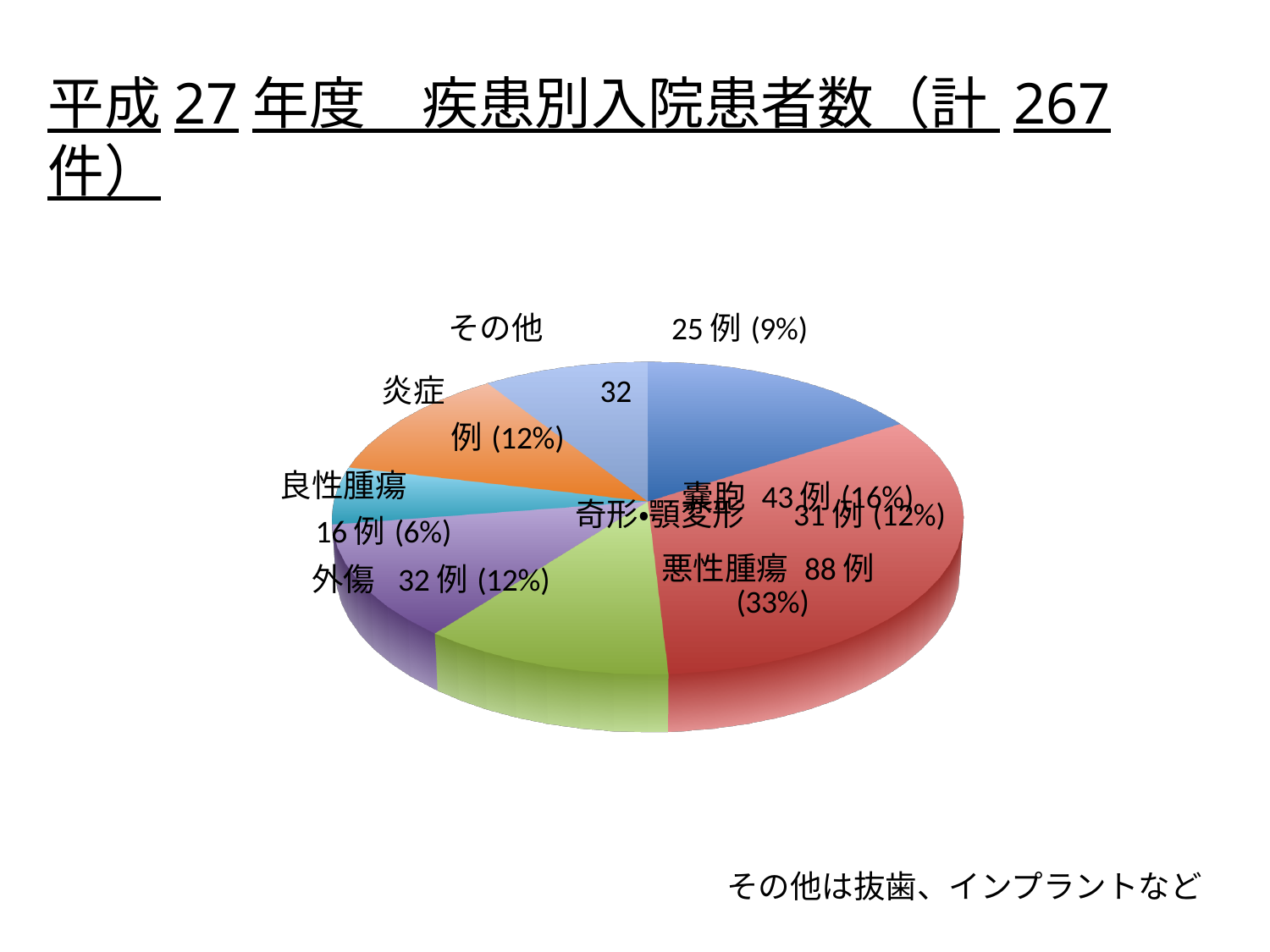
According to the slide title, what is the total number of cases in the chart? 267 件 Which category has the largest slice in the pie chart? 悪性腫瘍 How many slices does the pie chart have? 7 Which has more cases, 外傷 or 良性腫瘍? 外傷 How many cases are shown for 良性腫瘍? 16 例 What share of the pie does 良性腫瘍 account for? 6% How many cases are shown for 外傷? 32 例 What is the difference in cases between 悪性腫瘍 and 外傷? 56 例 What kind of chart is shown on the slide? pie chart How many cases are shown for 悪性腫瘍? 88 例 Which category has the smallest slice in the pie chart? 良性腫瘍 What share of the pie does 悪性腫瘍 account for? 33%